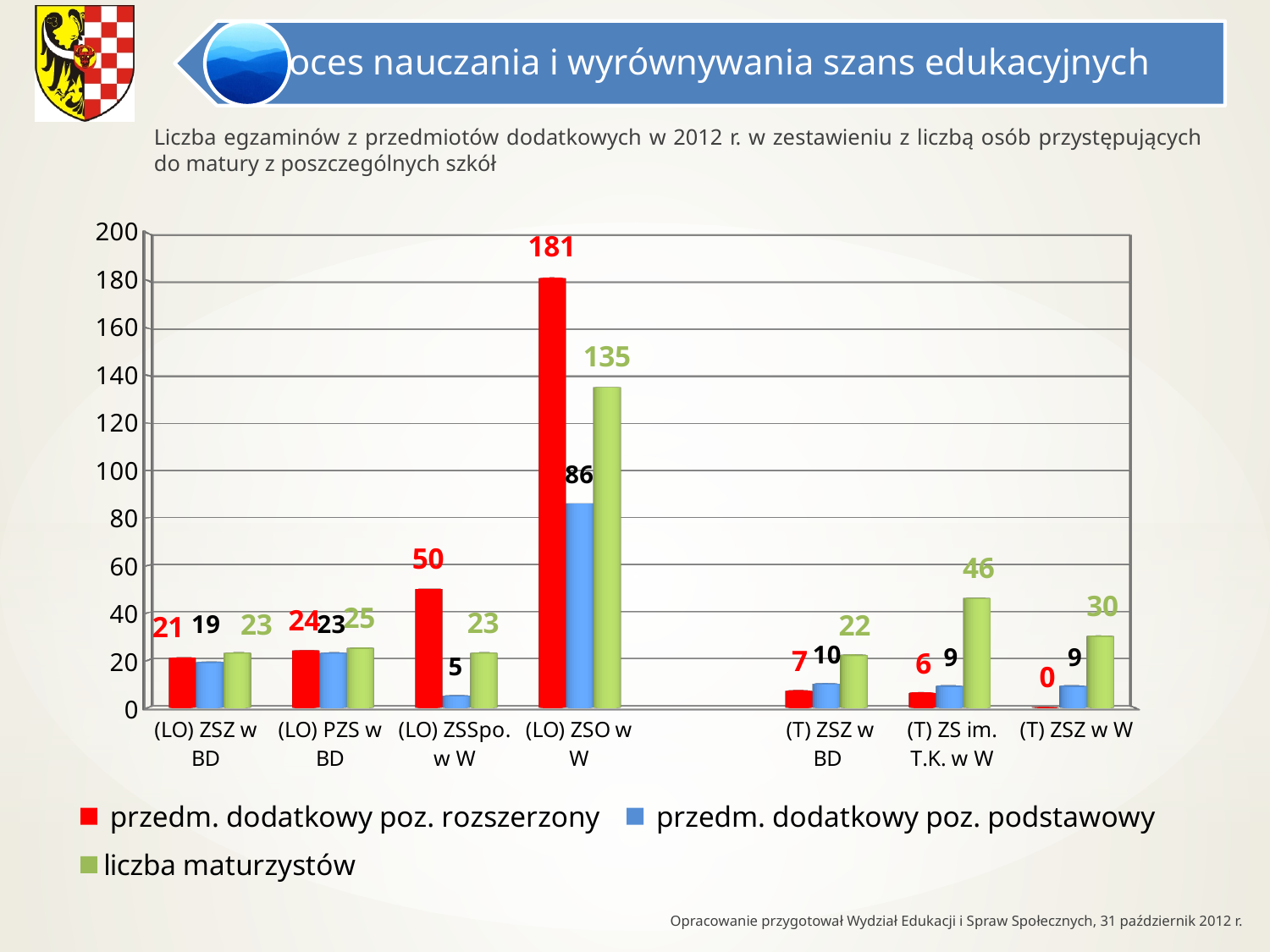
Which colour represents 'liczba maturzystów' in the chart? green What is the value of 'przedm. dodatkowy poz. rozszerzony' for (LO) ZSO w W? 181 What kind of chart is shown on the slide? bar chart How many series does the legend list? 3 What is the value of 'liczba maturzystów' for (T) ZS im. T.K. w W? 46 Which school has the highest value for 'liczba maturzystów'? (LO) ZSO w W What is the value of 'przedm. dodatkowy poz. podstawowy' for (LO) ZSSpo. w W? 5 Which school has the lowest value for 'przedm. dodatkowy poz. rozszerzony'? (T) ZSZ w W What is the value of 'przedm. dodatkowy poz. rozszerzony' for (T) ZSZ w W? 0 Which is larger for (T) ZSZ w BD: 'przedm. dodatkowy poz. rozszerzony' or 'liczba maturzystów'? liczba maturzystów What is the difference between 'przedm. dodatkowy poz. rozszerzony' and 'przedm. dodatkowy poz. podstawowy' for (LO) ZSO w W? 95 How many schools (categories) are shown on the x axis? 7